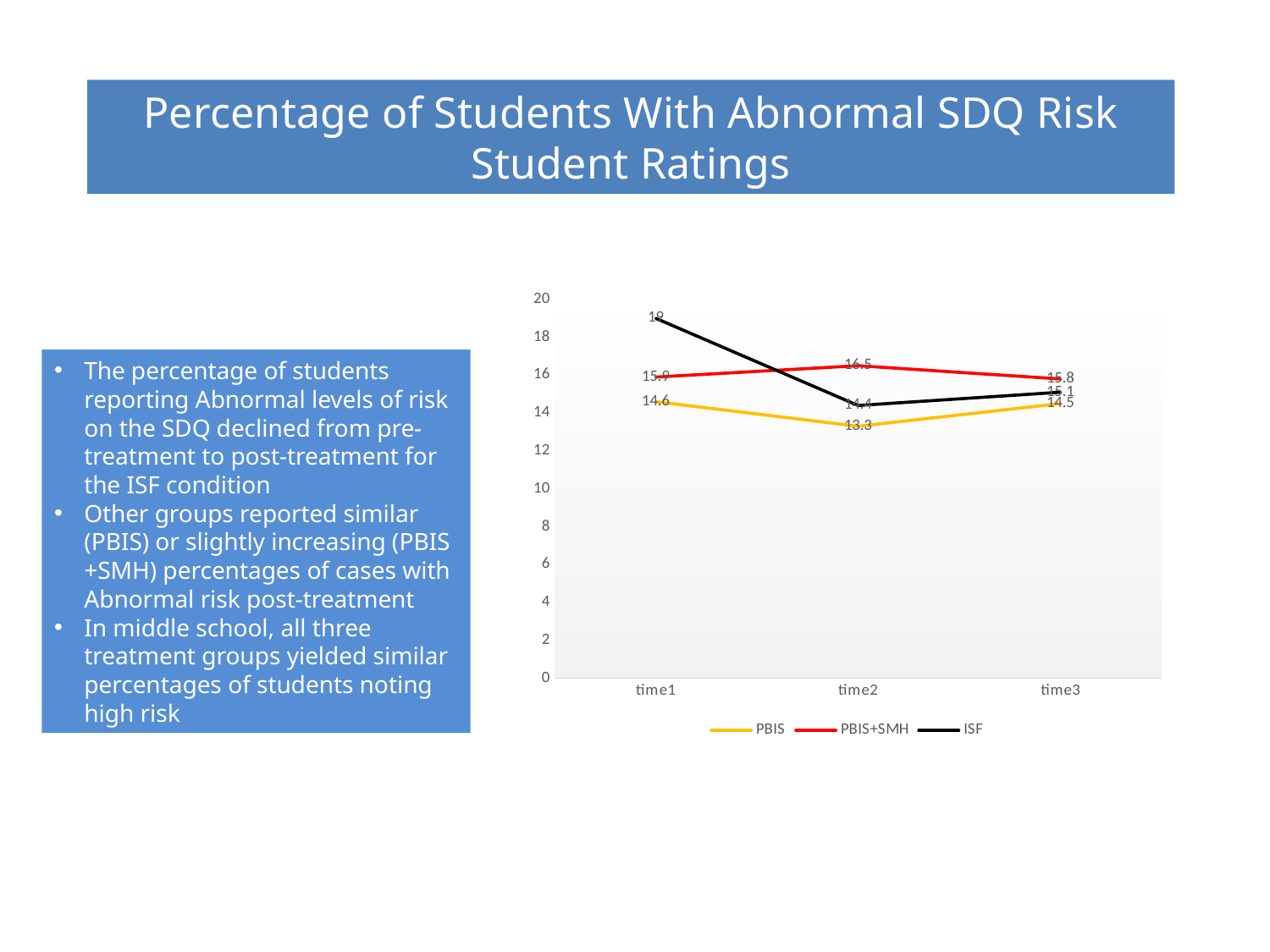
What kind of chart is shown on the slide? line chart What is the difference between the ISF values at time1 and time2? 4.6 How many series does the legend list? 3 How many time points are plotted on the x axis? 3 What is the value for PBIS at time2? 13.3 What is the value for ISF at time1? 19 What is the value for PBIS+SMH at time3? 15.8 Which series has the highest value at time1? ISF Which colour is used for the PBIS+SMH line? red Which series has the lowest value at time2? PBIS Which is larger at time2, PBIS+SMH or ISF? PBIS+SMH Does the ISF line rise or fall from time1 to time2? fall